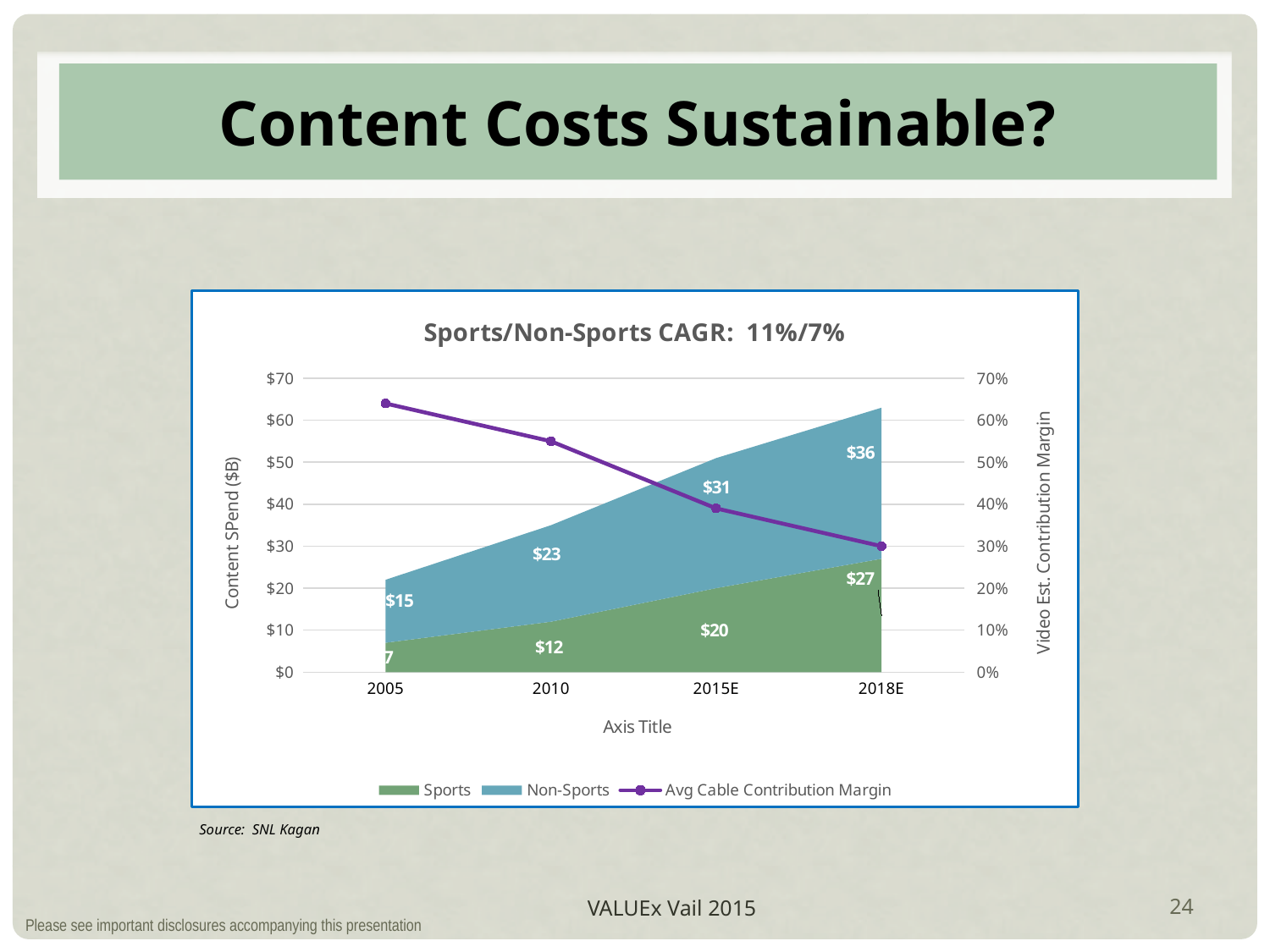
What is the Non-Sports content spend value shown for 2018E? $36 What is the total content spend (Sports plus Non-Sports) for 2010? $35 Is the Avg Cable Contribution Margin for 2005 greater or less than 60%? greater What is the difference between the Non-Sports values for 2018E and 2015E? $5 Which is larger in 2015E, the Sports value or the Non-Sports value? Non-Sports What is the Non-Sports value shown for 2005? $15 How many series does the legend list? 3 What is the Sports value shown for 2010? $12 Does the Avg Cable Contribution Margin line rise or fall from 2005 to 2018E? fall What is the total content spend (Sports plus Non-Sports) for 2018E? $63 What is the Sports content spend value shown for 2015E? $20 In which year is the Non-Sports content spend highest? 2018E